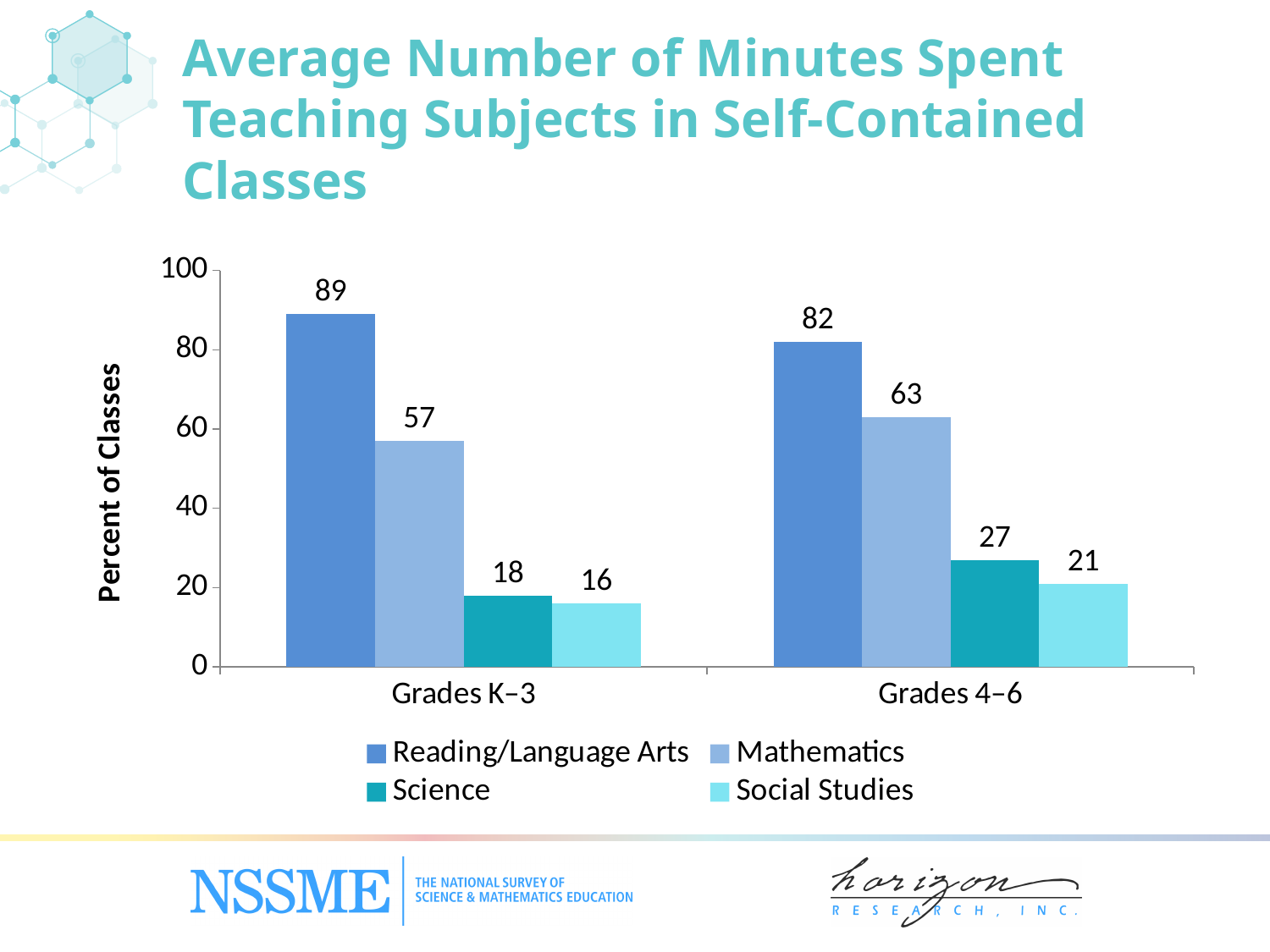
How many series does the legend list? 4 Which subject has the highest value in Grades 4–6? Reading/Language Arts What is the value for Social Studies in Grades 4–6? 21 What is the difference between Reading/Language Arts and Mathematics in Grades K–3? 32 What is the value for Reading/Language Arts in Grades K–3? 89 Which is larger: Science in Grades K–3 or Science in Grades 4–6? Science in Grades 4–6 What is the value for Mathematics in Grades 4–6? 63 What kind of chart is shown on the slide? Bar chart Which subject has the lowest value in Grades K–3? Social Studies What is the value for Science in Grades K–3? 18 How many grade-band categories are shown on the x axis? 2 What is the label of the vertical axis? Percent of Classes